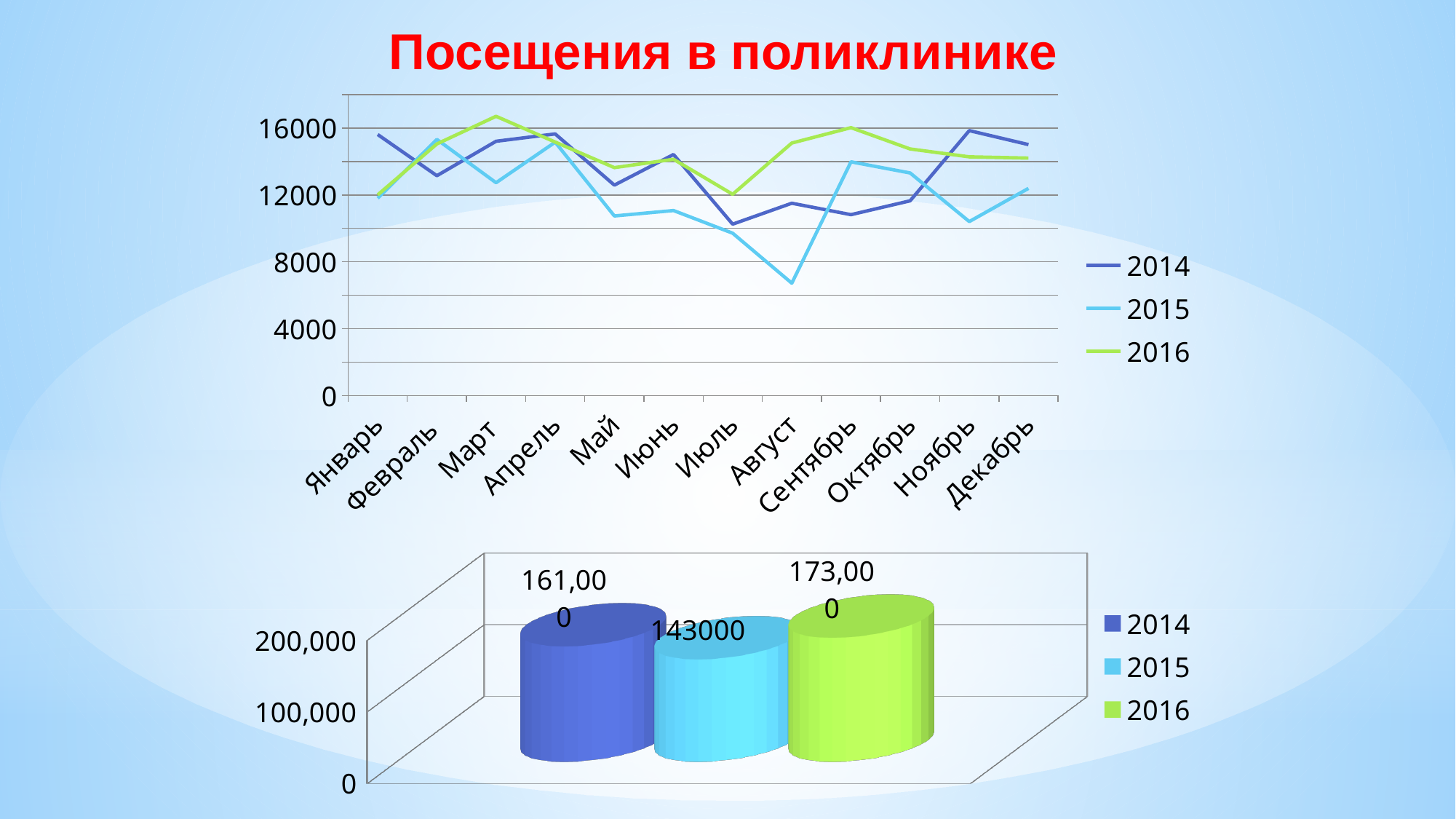
In the bottom bar chart, what is the value for 2015? 143000 What kind of chart is the top chart on the slide? line chart In the bottom bar chart, what is the value for 2014? 161,000 In the top line chart, is the value for 2016 in Март greater or less than 16000? greater What kind of chart is the bottom chart on the slide? bar chart In the top line chart, which month has the lowest value for 2015? Август In the bottom bar chart, what is the difference between the values for 2016 and 2014? 12,000 In the top line chart, is the value for 2015 in Август greater or less than 8000? less In the bottom bar chart, which year has the highest value? 2016 In the top line chart, is the value for 2014 in Июль greater or less than 12000? less How many months are shown on the x axis of the top line chart? 12 How many series does the legend of the top line chart list? 3